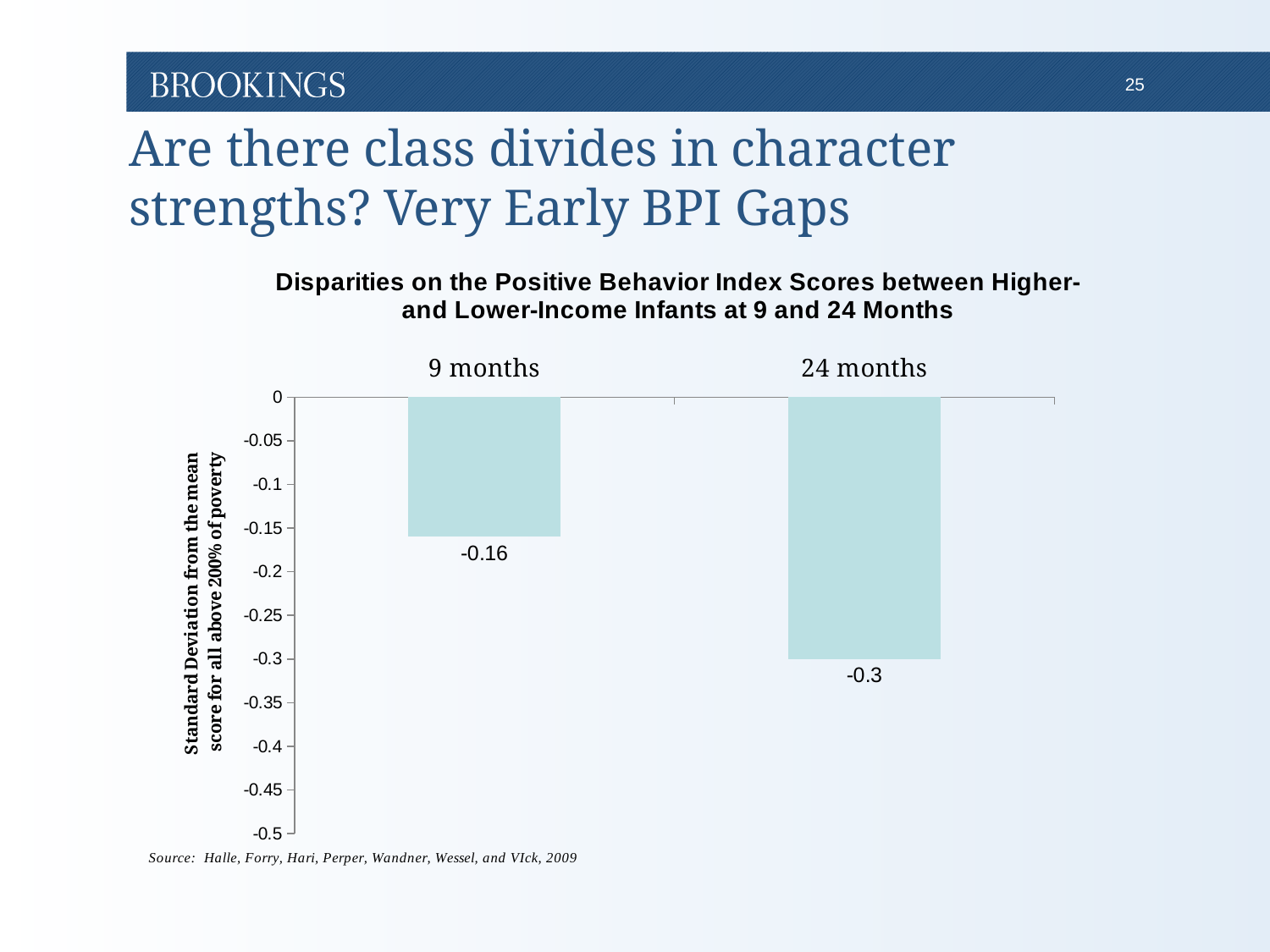
What kind of chart is shown on the slide? bar chart Do the values rise or fall from 9 months to 24 months? fall How many categories are shown in the chart? 2 Is the value for 9 months greater or less than -0.2? greater What is the difference between the values for 9 months and 24 months? 0.14 What is the value for 9 months? -0.16 Which has a larger disparity in magnitude, 9 months or 24 months? 24 months What is the value for 24 months? -0.3 What is the title of the chart? Disparities on the Positive Behavior Index Scores between Higher- and Lower-Income Infants at 9 and 24 Months Which category has the lowest (most negative) value? 24 months Is the value for 24 months greater or less than -0.2? less Which category has the highest (least negative) value? 9 months